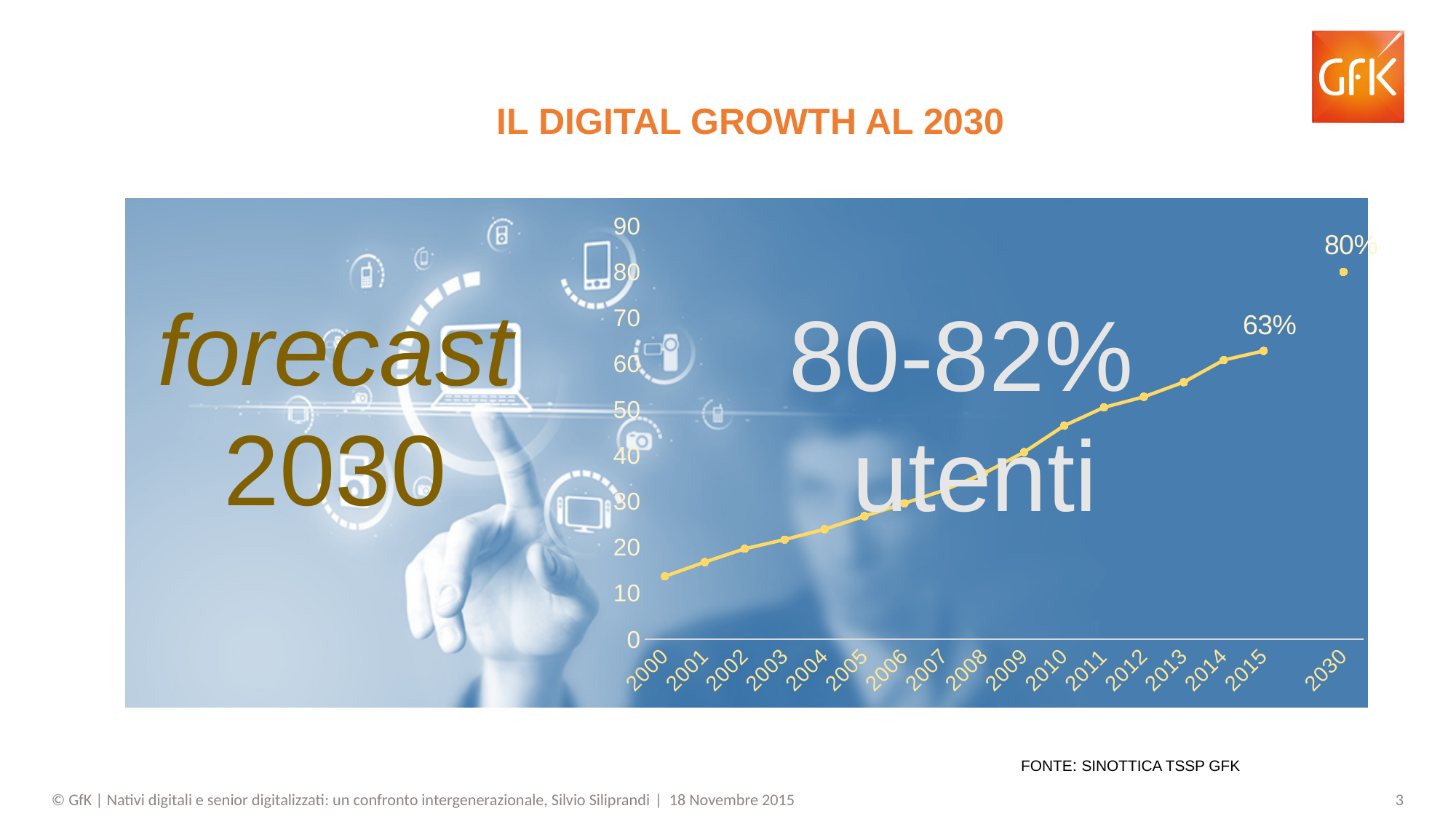
What is the title of the slide? IL DIGITAL GROWTH AL 2030 Which is larger, the value for 2015 or the value for 2030? 2030 How many years are labelled on the x axis? 17 Which year has the lowest plotted value? 2000 What is the difference between the 2030 value and the 2015 value? 17 percentage points What is the value plotted for 2015? 63% Which year has the highest plotted value? 2030 Is the value for 2008 greater or less than 30? greater Do the values rise or fall from 2000 to 2015? rise What is the forecast value plotted for 2030? 80% What type of chart is shown on the slide? line chart Is the value for 2000 greater or less than 20? less